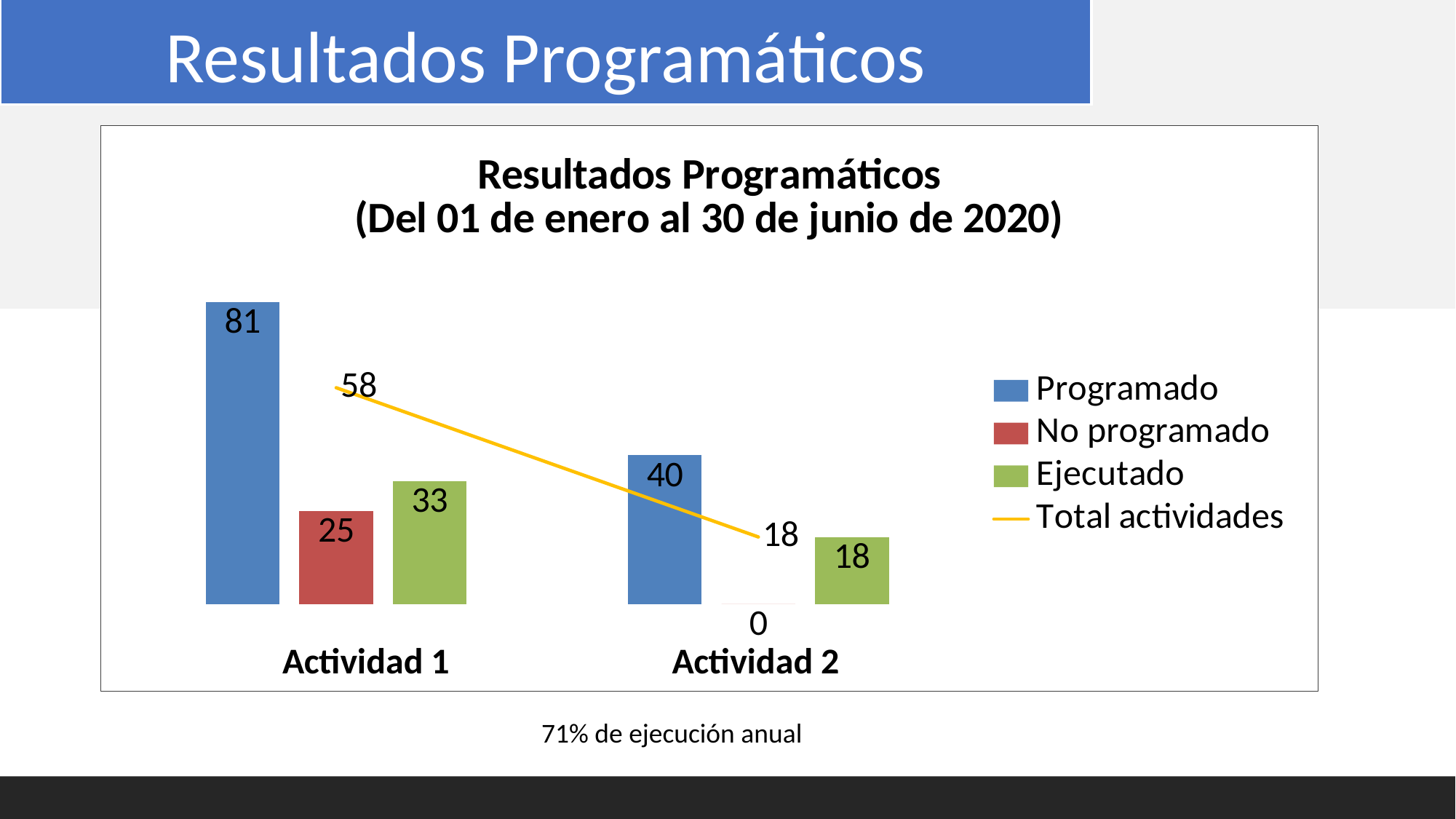
How many categories are shown on the x axis? 2 What is the Programado value for Actividad 1? 81 What is the No programado value for Actividad 2? 0 What is the Total actividades value for Actividad 1? 58 Which category has the lowest Ejecutado value? Actividad 2 Does the Total actividades line rise or fall from Actividad 1 to Actividad 2? fall What is the difference between the Programado values for Actividad 1 and Actividad 2? 41 Which is larger for Actividad 1: the No programado value or the Ejecutado value? Ejecutado Which category has the highest Programado value? Actividad 1 What is the title of the chart? Resultados Programáticos (Del 01 de enero al 30 de junio de 2020) What is the Ejecutado value for Actividad 2? 18 How many series does the legend list? 4